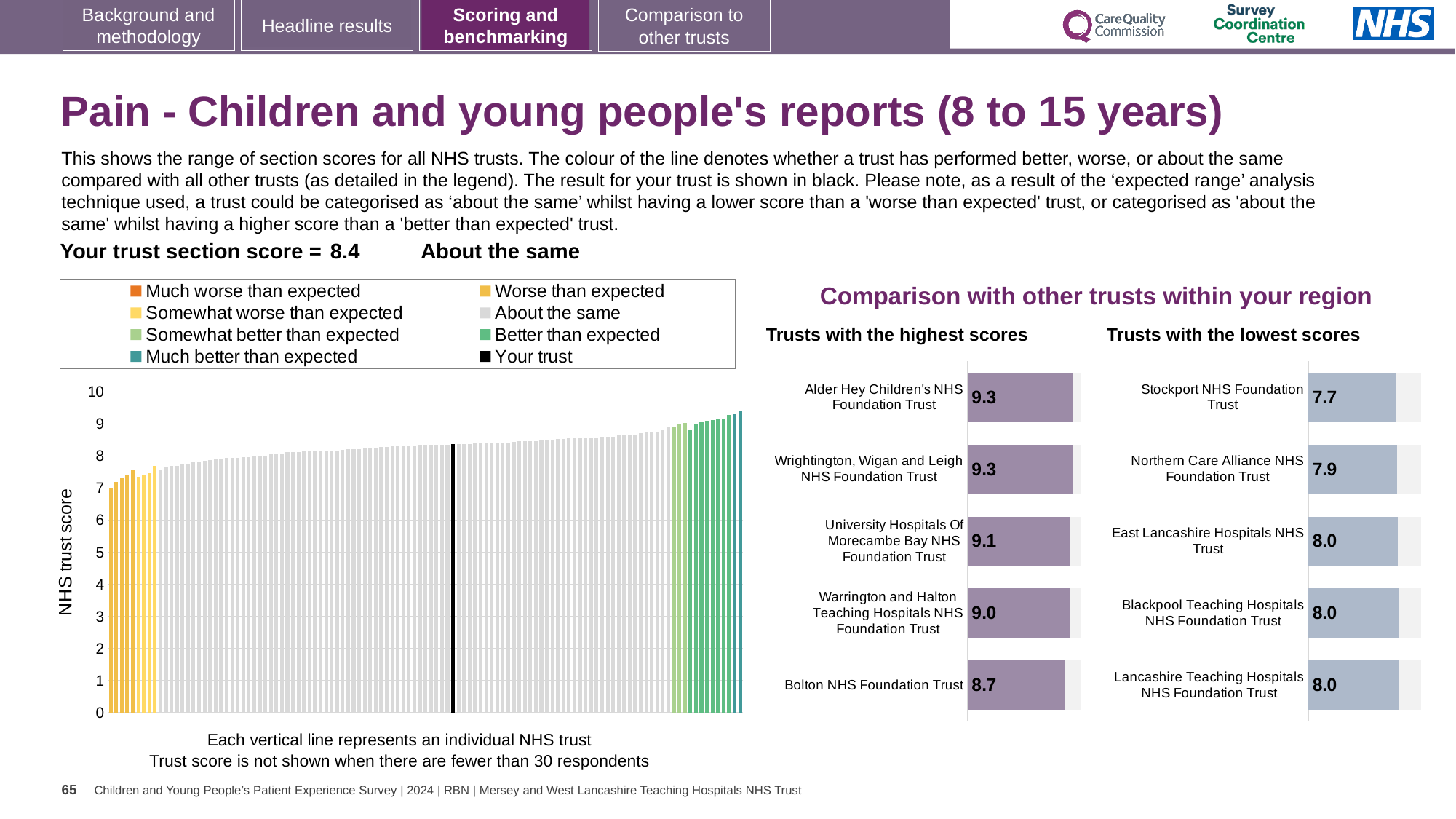
On the main 'NHS trust score' chart, do the trust scores rise or fall from left to right? rise On the 'Trusts with the lowest scores' chart, which trust has the lowest score? Stockport NHS Foundation Trust On the 'Trusts with the lowest scores' chart, what is the score for Northern Care Alliance NHS Foundation Trust? 7.9 On the main 'NHS trust score' chart, how many entries does the legend list? 8 What kind of chart is the main 'NHS trust score' chart? bar chart On the 'Trusts with the lowest scores' chart, which has the larger score: Stockport NHS Foundation Trust or Northern Care Alliance NHS Foundation Trust? Northern Care Alliance NHS Foundation Trust On the main 'NHS trust score' chart, what is your trust's section score? 8.4 On the 'Trusts with the highest scores' chart, how many trusts are shown? 5 On the 'Trusts with the highest scores' chart, which trust has the lowest score? Bolton NHS Foundation Trust On the 'Trusts with the highest scores' chart, what is the difference between the scores of Alder Hey Children's NHS Foundation Trust and Bolton NHS Foundation Trust? 0.6 On the 'Trusts with the highest scores' chart, what is the score for Bolton NHS Foundation Trust? 8.7 On the main 'NHS trust score' chart, what colour is used for 'Your trust' in the legend? black